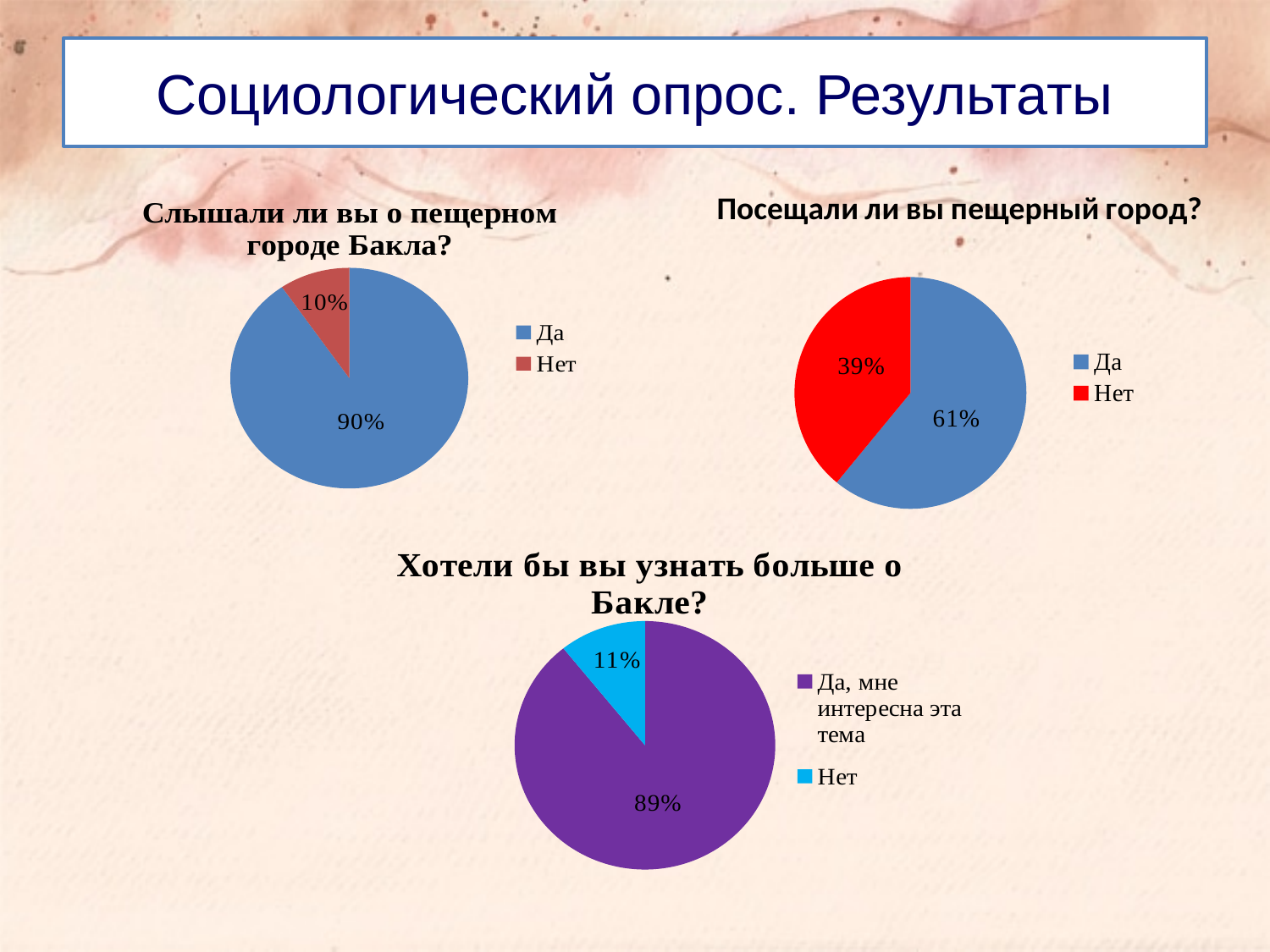
How many entries does the legend of the chart titled "Хотели бы вы узнать больше о Бакле?" list? 2 In the chart titled "Слышали ли вы о пещерном городе Бакла?", which answer has the largest slice? Да In the chart titled "Слышали ли вы о пещерном городе Бакла?", what share of respondents answered "Да"? 90% In the chart titled "Посещали ли вы пещерный город?", what colour is the "Нет" slice? Red In the chart titled "Хотели бы вы узнать больше о Бакле?", what share of respondents answered "Да, мне интересна эта тема"? 89% In the chart titled "Хотели бы вы узнать больше о Бакле?", what share of respondents answered "Нет"? 11% In the chart titled "Посещали ли вы пещерный город?", what share of respondents answered "Да"? 61% In the chart titled "Слышали ли вы о пещерном городе Бакла?", what share of respondents answered "Нет"? 10% In the chart titled "Посещали ли вы пещерный город?", which answer has the smallest slice? Нет What type of chart is the chart titled "Хотели бы вы узнать больше о Бакле?"? Pie chart In the chart titled "Посещали ли вы пещерный город?", what share of respondents answered "Нет"? 39% In the chart titled "Посещали ли вы пещерный город?", what is the difference between the "Да" and "Нет" shares? 22%